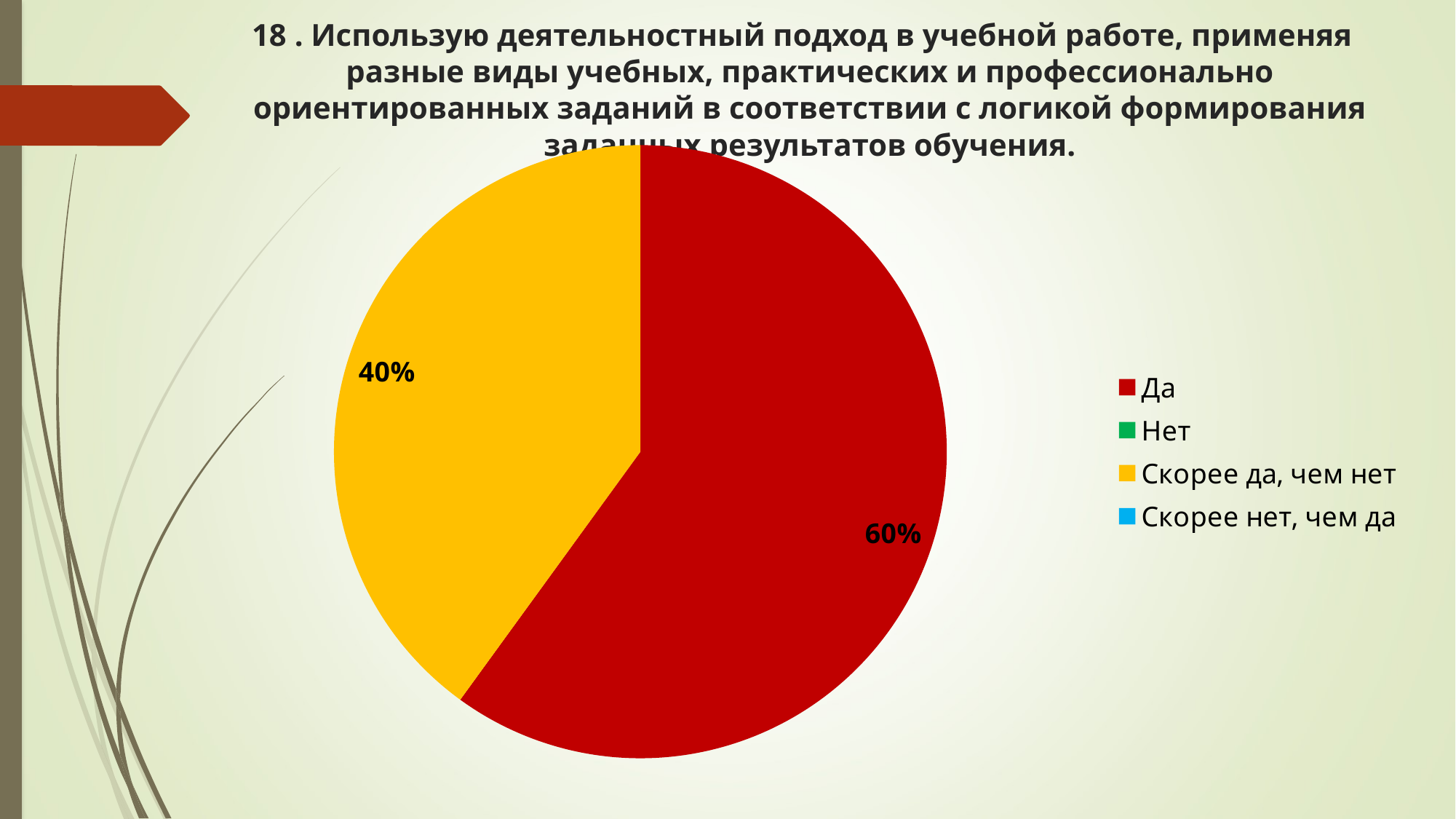
What is the difference in percentage points between the "Да" slice and the "Скорее да, чем нет" slice? 20% How many slices are visible in the pie? 2 Which category has the largest slice of the pie? Да What kind of chart is shown on the slide? pie chart Which of the two visible slices is larger, "Да" or "Скорее да, чем нет"? Да What share of the pie does the "Да" slice represent? 60% What colour is the "Скорее да, чем нет" slice? yellow Is the share for "Да" greater or less than 50%? greater What share of the pie does the "Скорее да, чем нет" slice represent? 40% How many entries does the legend list? 4 What colour is the "Да" slice? red